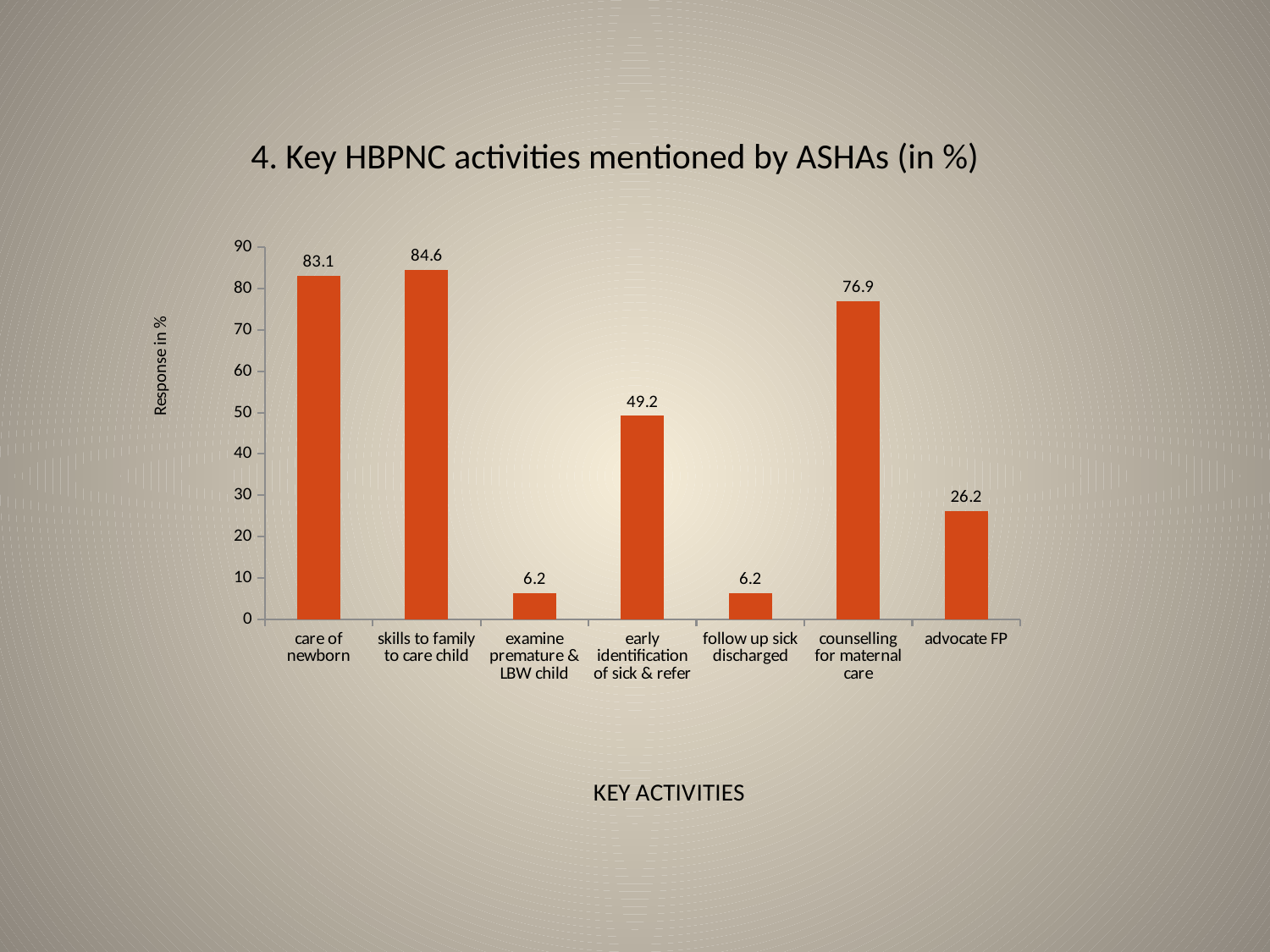
What is the value for 'care of newborn'? 83.1 What kind of chart is this? bar chart How many activities are shown on the x axis? 7 What is the value for 'advocate FP'? 26.2 What is the label of the y axis? Response in % Which is larger, 'early identification of sick & refer' or 'advocate FP'? early identification of sick & refer What is the value for 'counselling for maternal care'? 76.9 What is the difference between 'counselling for maternal care' and 'advocate FP'? 50.7 Is the value for 'early identification of sick & refer' greater or less than 50? less What is the title of the chart? 4. Key HBPNC activities mentioned by ASHAs (in %) Which activity has the highest value? skills to family to care child What is the difference between 'skills to family to care child' and 'care of newborn'? 1.5